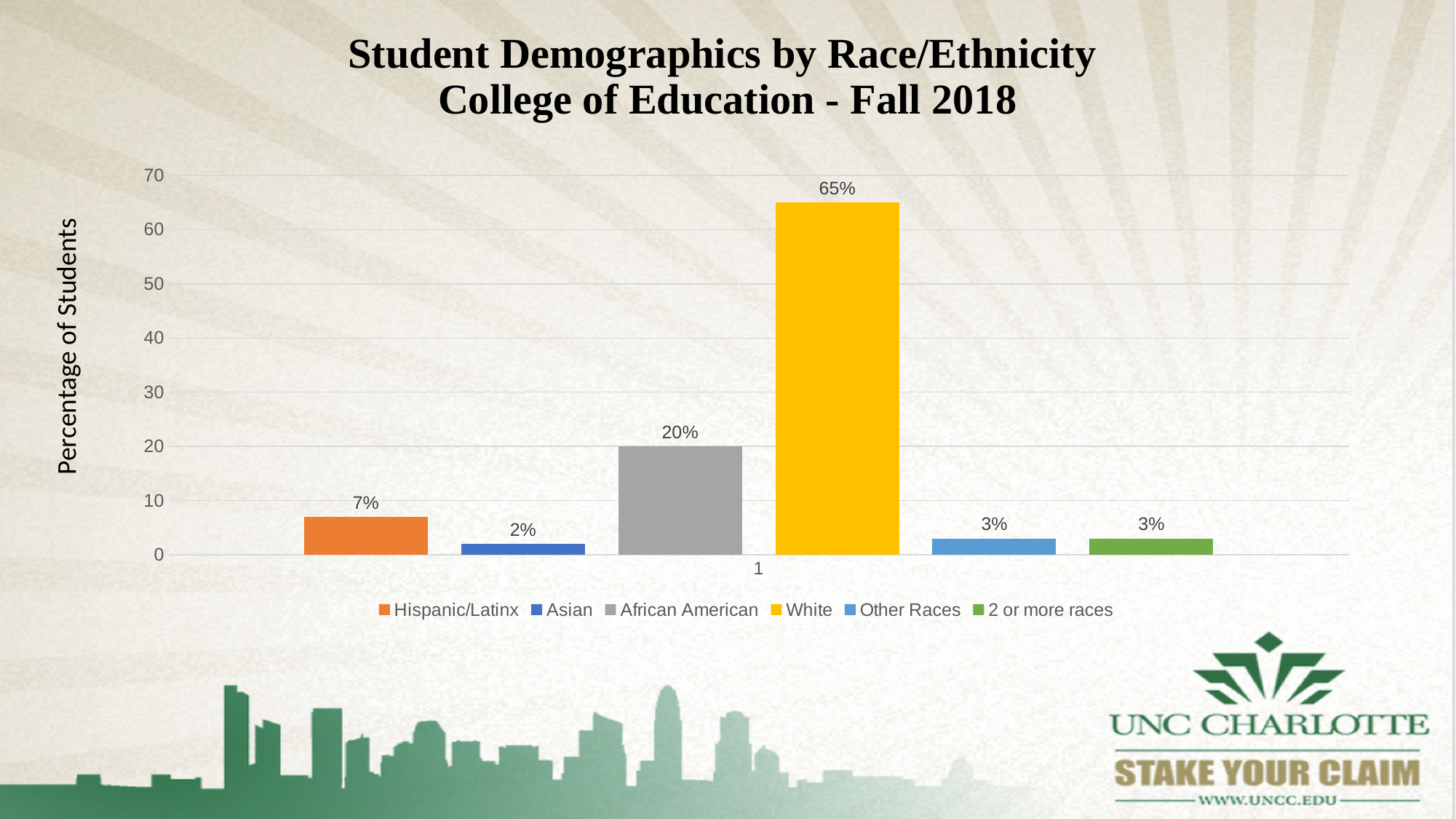
Which is larger, the percentage for Hispanic/Latinx or for Other Races? Hispanic/Latinx Which race/ethnicity group has the highest percentage of students? White How many series does the legend list? 6 What percentage of students are Asian? 2% What percentage of students are Hispanic/Latinx? 7% What percentage of students are African American? 20% What is the difference in percentage points between Hispanic/Latinx and Asian students? 5 Which race/ethnicity group has the lowest percentage of students? Asian What is the label on the vertical axis of the chart? Percentage of Students What is the difference in percentage points between White and African American students? 45 What percentage of students are White? 65% What kind of chart is shown on the slide? Bar chart